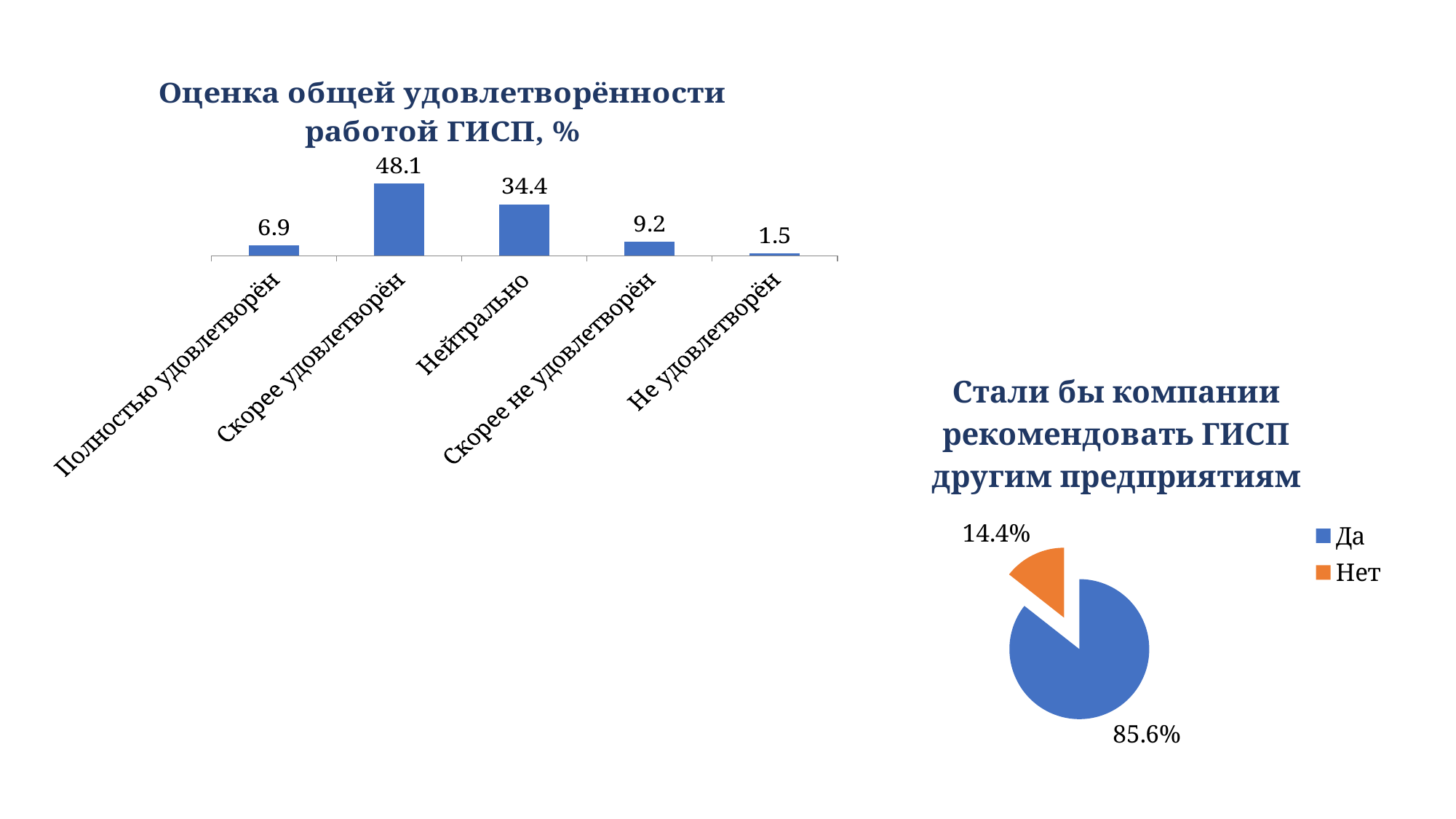
In the bar chart 'Оценка общей удовлетворённости работой ГИСП, %', what is the value for 'Скорее удовлетворён'? 48.1 What kind of chart is the chart on the left of the slide? Bar chart How many categories are shown in the bar chart 'Оценка общей удовлетворённости работой ГИСП, %'? 5 In the bar chart 'Оценка общей удовлетворённости работой ГИСП, %', which category has the highest value? Скорее удовлетворён How many entries does the legend of the pie chart 'Стали бы компании рекомендовать ГИСП другим предприятиям' list? 2 In the bar chart 'Оценка общей удовлетворённости работой ГИСП, %', what is the value for 'Не удовлетворён'? 1.5 In the bar chart 'Оценка общей удовлетворённости работой ГИСП, %', which category has the lowest value? Не удовлетворён In the pie chart 'Стали бы компании рекомендовать ГИСП другим предприятиям', what share is 'Нет'? 14.4% In the bar chart 'Оценка общей удовлетворённости работой ГИСП, %', which is larger: 'Полностью удовлетворён' or 'Скорее не удовлетворён'? Скорее не удовлетворён In the bar chart 'Оценка общей удовлетворённости работой ГИСП, %', what is the value for 'Нейтрально'? 34.4 In the pie chart 'Стали бы компании рекомендовать ГИСП другим предприятиям', what share is 'Да'? 85.6% In the bar chart 'Оценка общей удовлетворённости работой ГИСП, %', what is the difference between 'Скорее удовлетворён' and 'Нейтрально'? 13.7